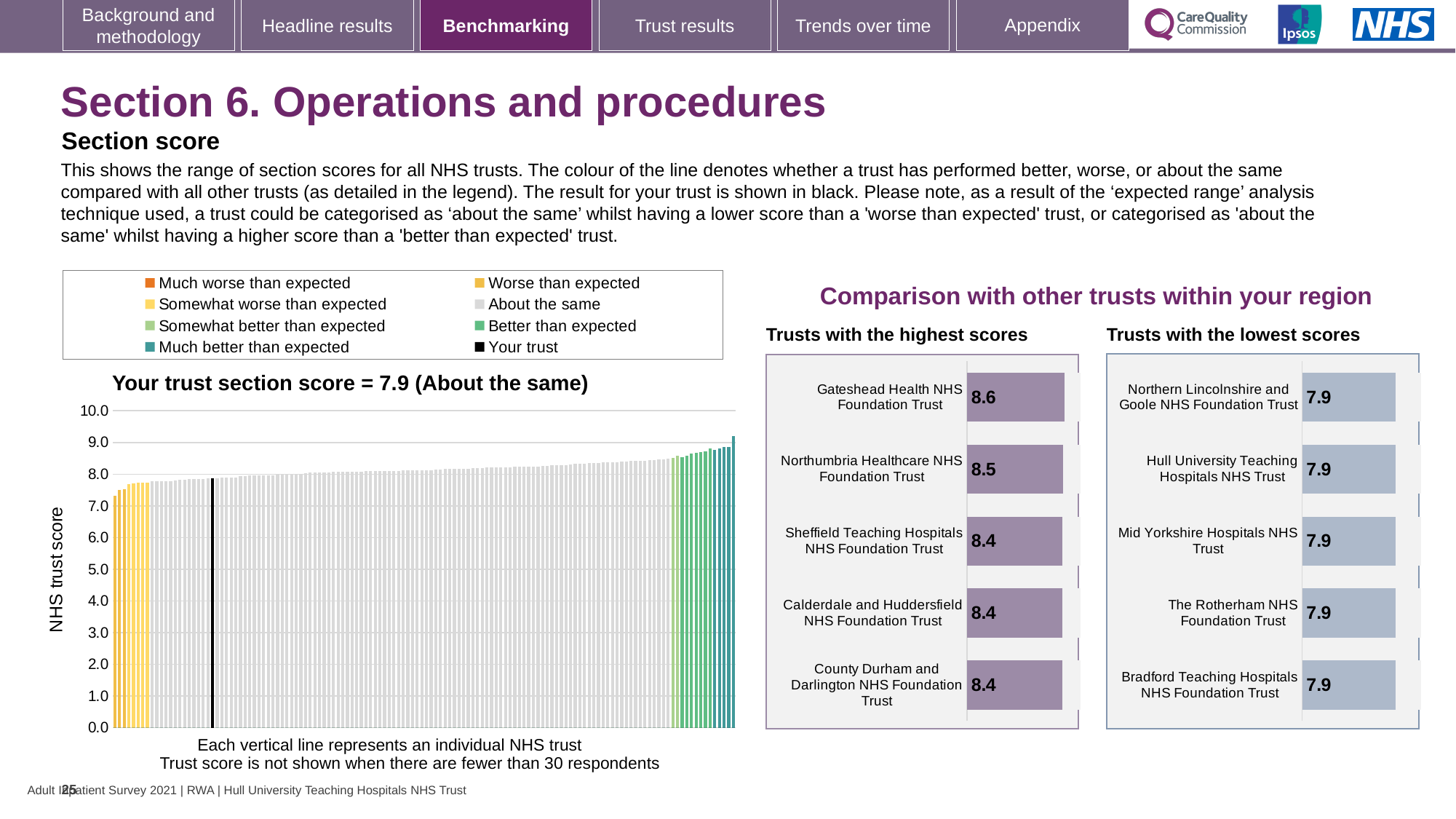
In the 'Your trust section score' chart, what is the section score for your trust? 7.9 How many entries does the legend above the 'Your trust section score' chart list? 8 What kind of chart is the 'Your trust section score' chart on the left? bar chart In the 'Trusts with the lowest scores' chart, how many trusts are listed? 5 In the 'Your trust section score' chart, what is the label on the vertical axis? NHS trust score Which is larger: the score for Gateshead Health NHS Foundation Trust in the 'Trusts with the highest scores' chart or the score for Hull University Teaching Hospitals NHS Trust in the 'Trusts with the lowest scores' chart? Gateshead Health NHS Foundation Trust In the 'Trusts with the highest scores' chart, which trust has the highest score? Gateshead Health NHS Foundation Trust In the 'Your trust section score' chart, is the value of the lowest (leftmost) bar greater or less than 8.0? less In the 'Trusts with the lowest scores' chart, what is the score for Bradford Teaching Hospitals NHS Foundation Trust? 7.9 In the 'Trusts with the highest scores' chart, what is the difference between the scores of Gateshead Health NHS Foundation Trust and Sheffield Teaching Hospitals NHS Foundation Trust? 0.2 In the 'Trusts with the highest scores' chart, how many trusts are shown? 5 In the 'Trusts with the highest scores' chart, what is the score for Gateshead Health NHS Foundation Trust? 8.6